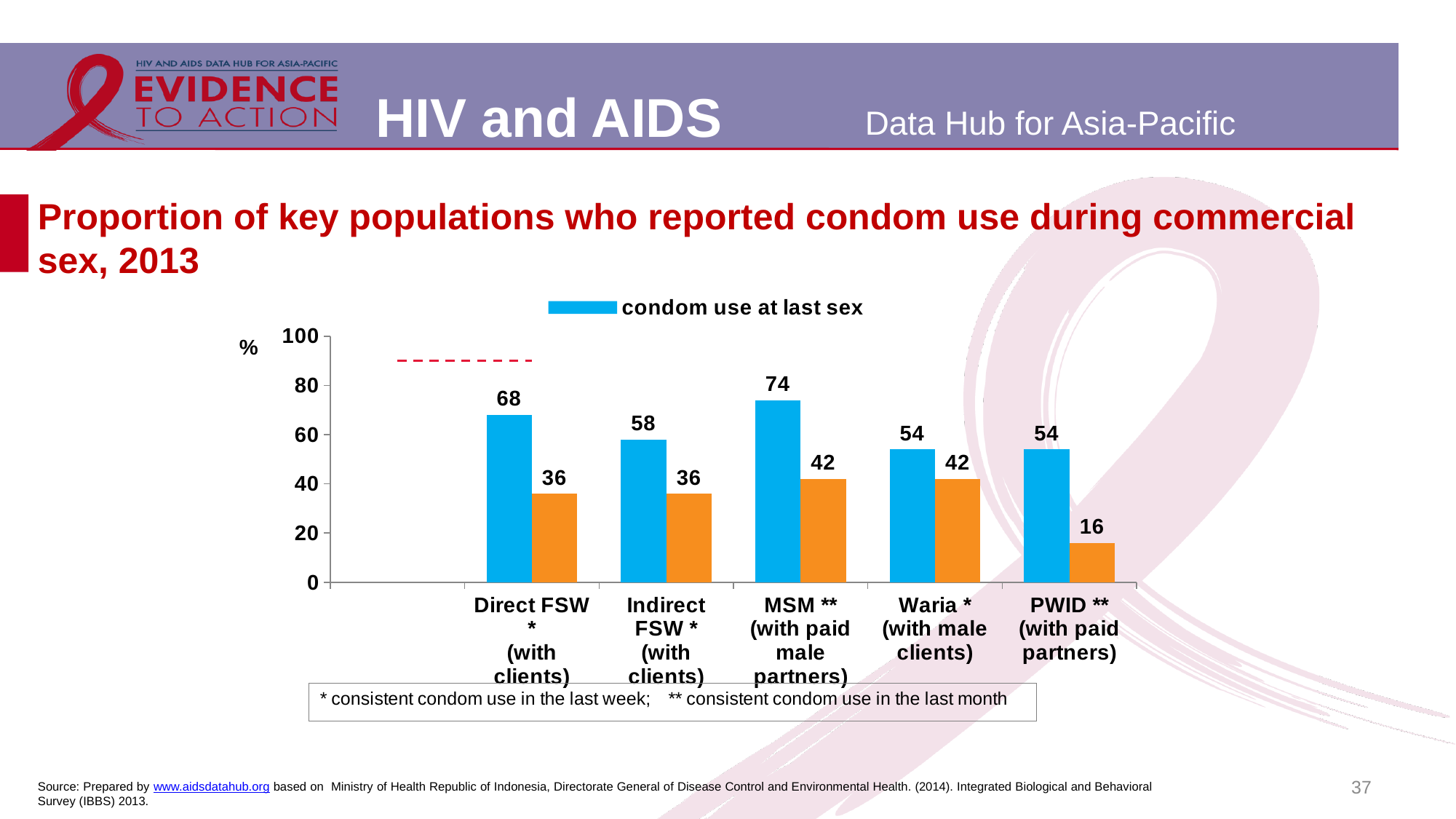
Is the value of condom use at last sex for Waria (with male clients) greater or less than 60? less What is the value of the orange bar for Waria (with male clients)? 42 What is the value of the orange bar for PWID (with paid partners)? 16 Which has a higher value for condom use at last sex, Direct FSW (with clients) or Indirect FSW (with clients)? Direct FSW * (with clients) What is the value of condom use at last sex for MSM (with paid male partners)? 74 What is the difference between the blue and orange bars for Direct FSW (with clients)? 32 Which category has the highest value for condom use at last sex? MSM ** (with paid male partners) How many key population categories are shown on the x axis? 5 What is the value of condom use at last sex for Indirect FSW (with clients)? 58 What is the difference between the blue and orange bars for PWID (with paid partners)? 38 Which category has the lowest value among the orange bars? PWID ** (with paid partners) What type of chart is shown on the slide? bar chart